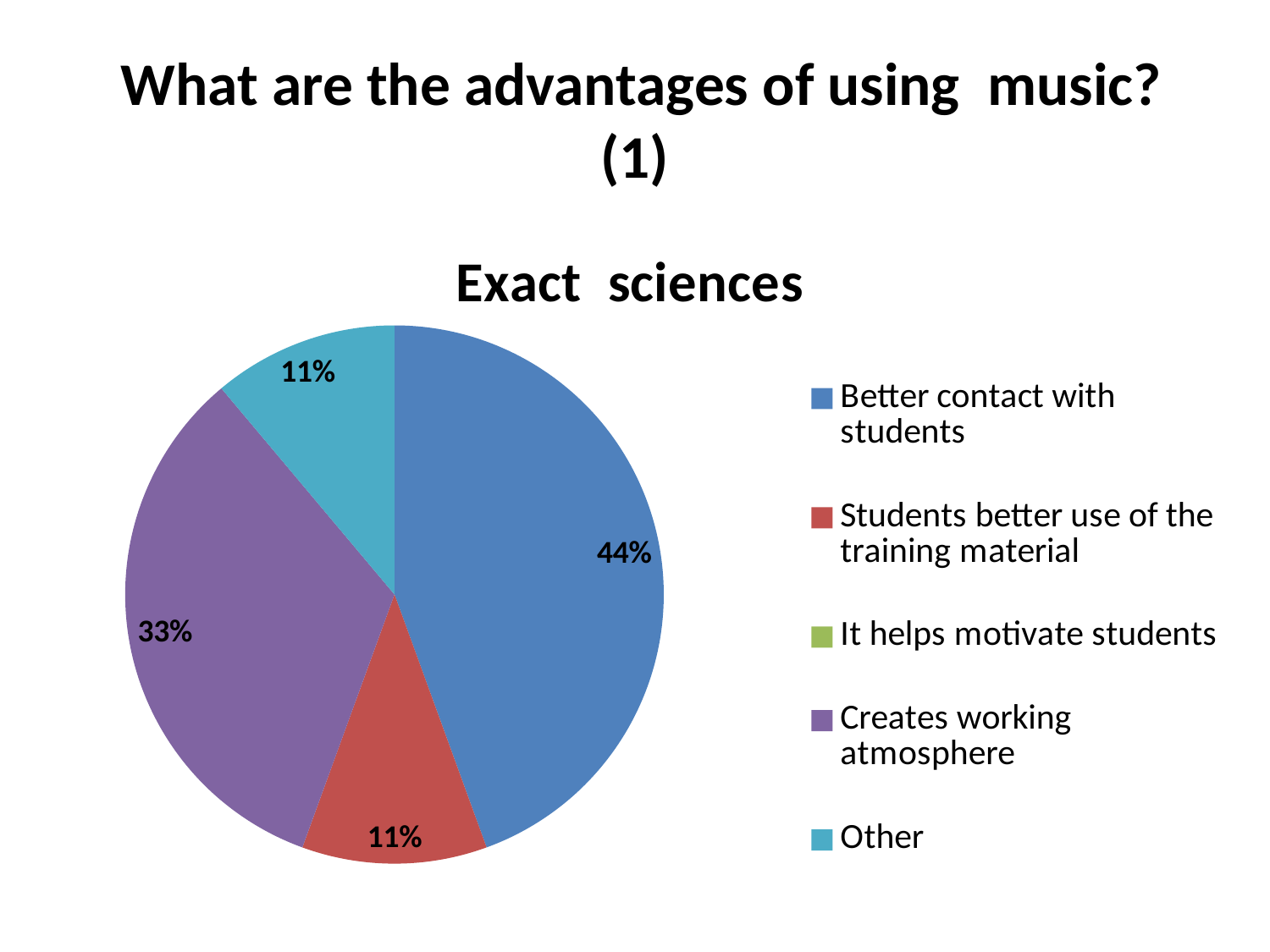
Which is larger: the slice for 'Creates working atmosphere' or the slice for 'Other'? Creates working atmosphere What percentage of the pie is 'Creates working atmosphere'? 33% What percentage of the pie is 'Students better use of the training material'? 11% How many entries does the legend list? 5 What is the difference in percentage points between 'Better contact with students' and 'Creates working atmosphere'? 11 What colour is the slice for 'Better contact with students'? blue Which category has the largest slice of the pie? Better contact with students What percentage of the pie is 'Better contact with students'? 44% What is the title of the chart? Exact sciences What share of the pie does the 'Other' slice represent? 11% What type of chart is shown on the slide? pie chart What percentage of the pie is 'Other'? 11%